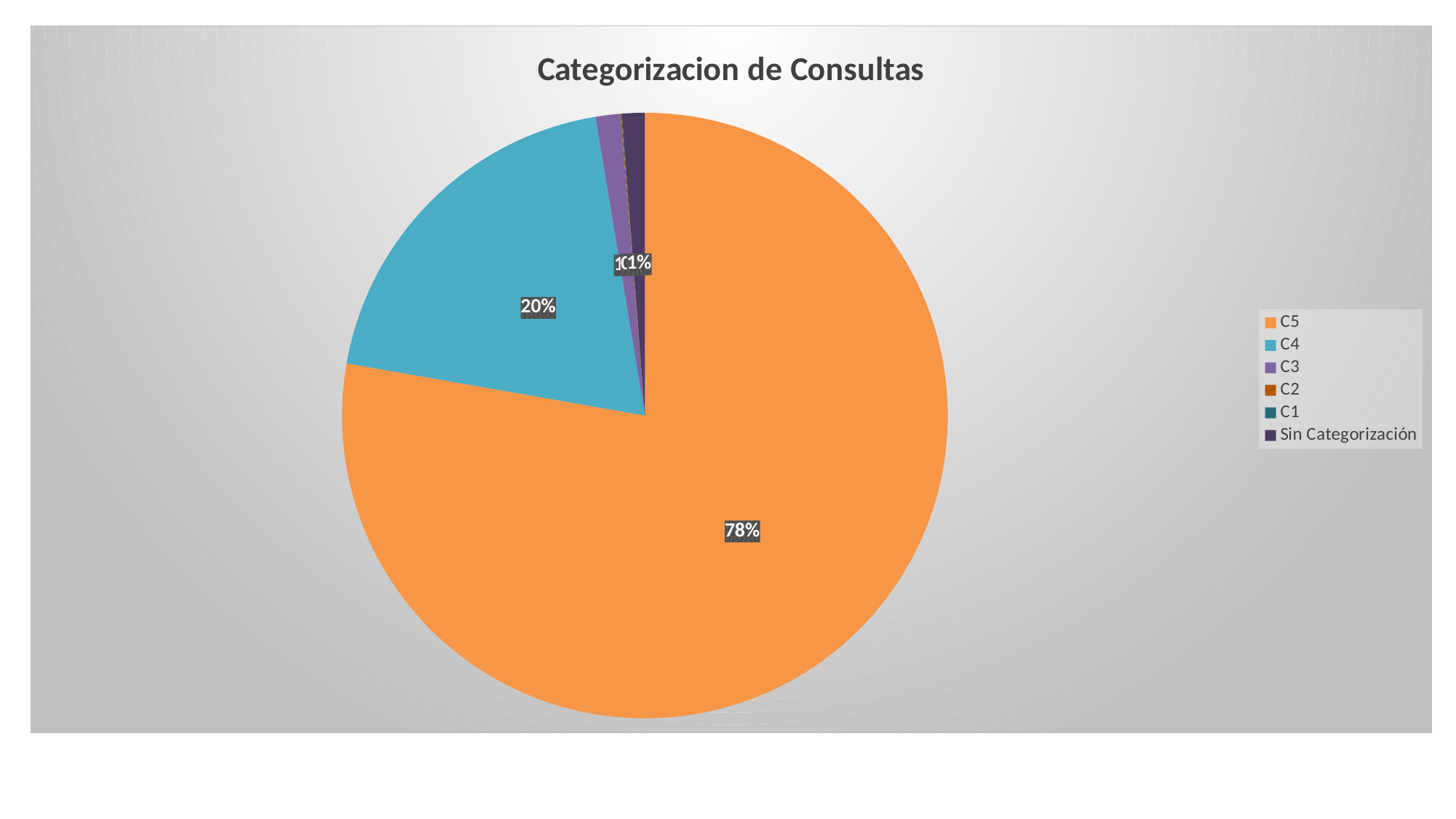
What colour is the C5 slice? Orange What percentage of the pie does C4 represent? 20% By how many percentage points does the C5 slice exceed the C4 slice? 58 percentage points Which slice is larger, C5 or C4? C5 Which category has the second largest slice of the pie? C4 What share of the pie is taken by C4? 20% What is the title of the chart? Categorizacion de Consultas Which category has the largest slice of the pie? C5 What percentage of the pie does C5 represent? 78% How many categories are listed in the legend? 6 What type of chart is shown on the slide? Pie chart